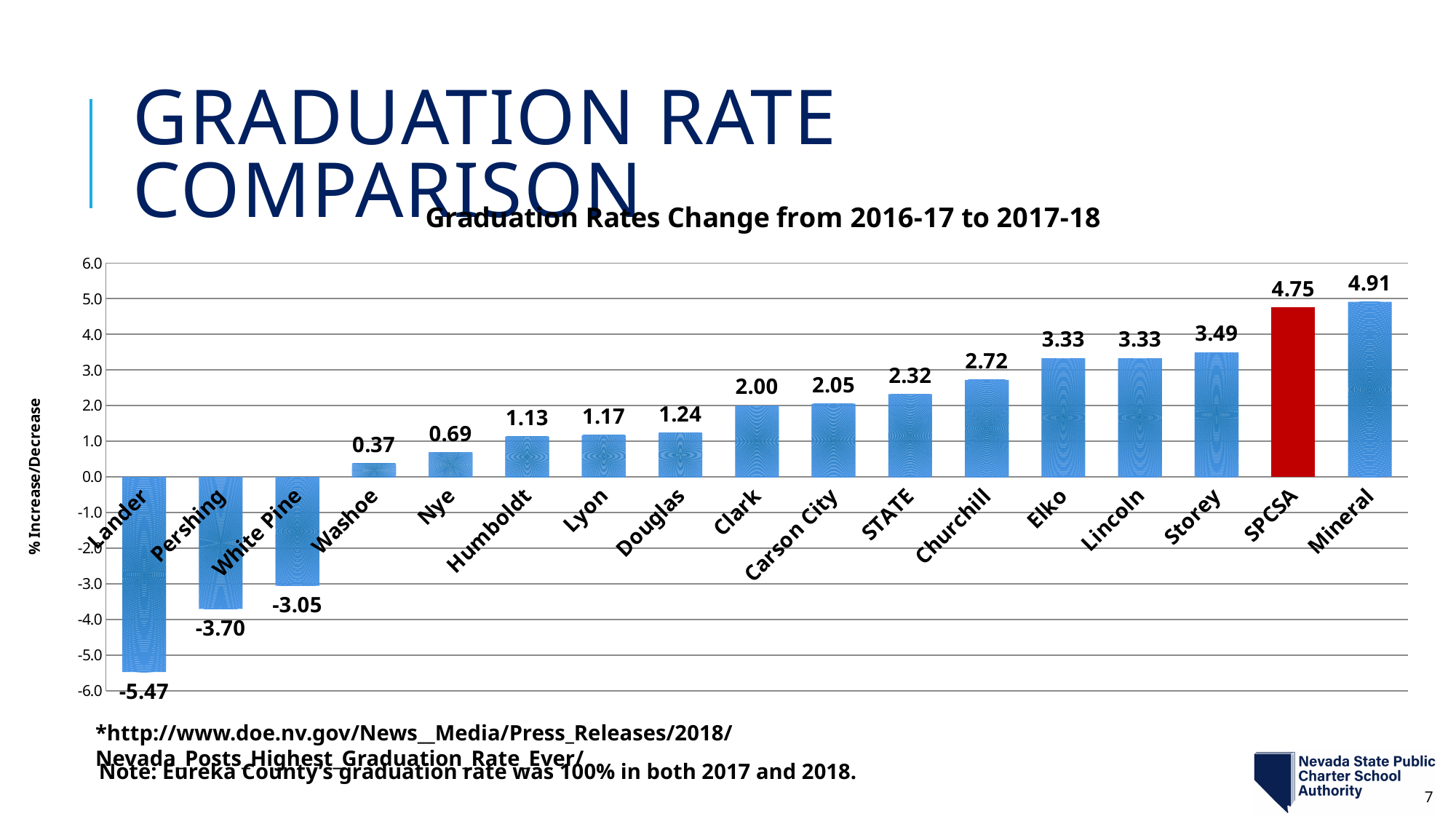
Which category has the lowest value in the chart? Lander How many categories are shown on the x axis of the chart? 17 Which category has the highest value in the chart? Mineral What is the difference between the values for Mineral and SPCSA? 0.16 What is the value for SPCSA in the chart? 4.75 What is the value for Lander in the chart? -5.47 What is the title of the chart? Graduation Rates Change from 2016-17 to 2017-18 Which is larger, the value for Storey or the value for Churchill? Storey Is the value for Elko greater or less than 3.0? greater What is the value for STATE in the chart? 2.32 Do the values rise or fall moving left to right along the x axis? rise What kind of chart is shown on the slide? bar chart